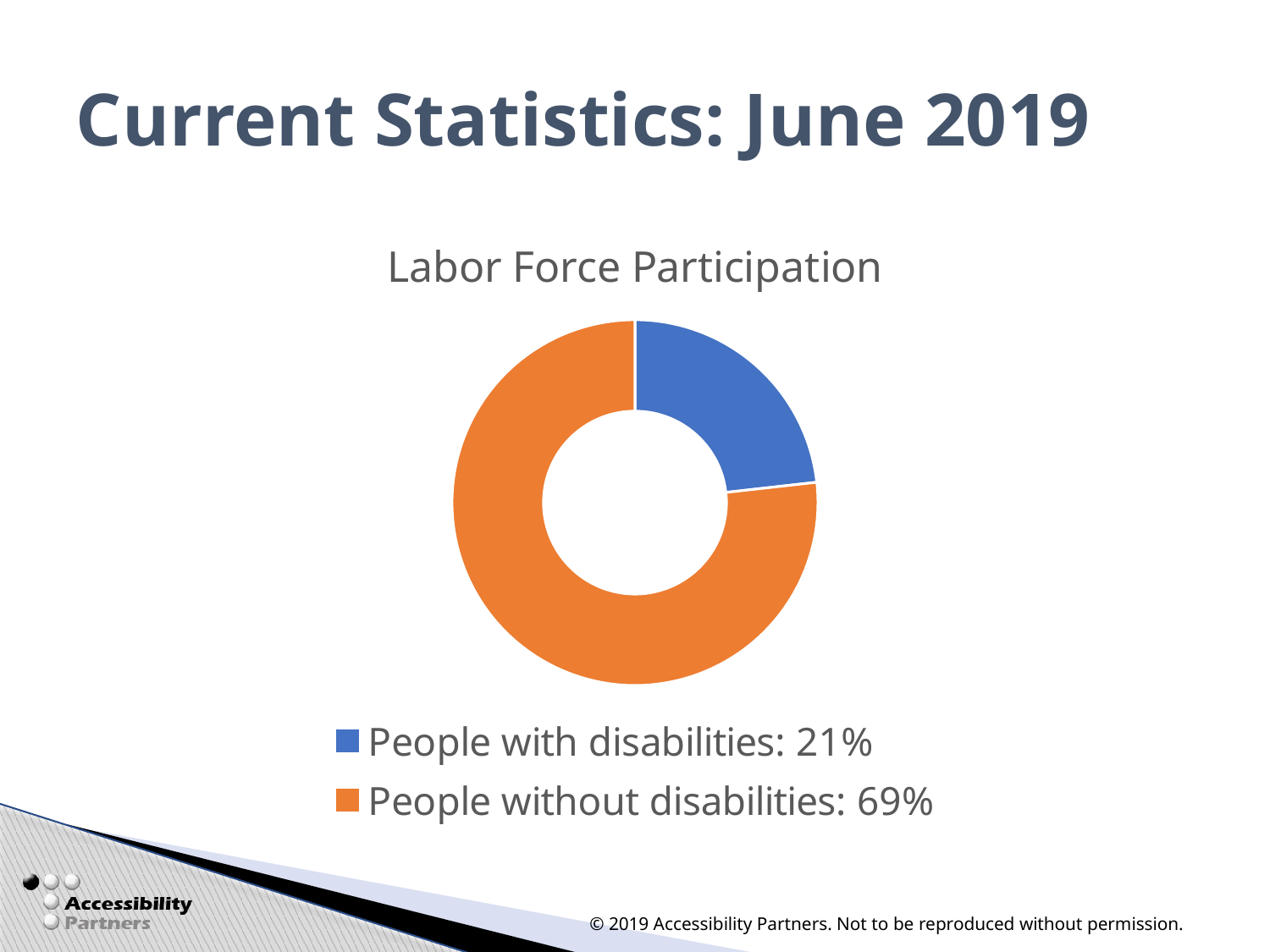
Which colour represents people with disabilities in the chart? Blue What is the title of the chart? Labor Force Participation What kind of chart is shown on the slide? Doughnut (pie) chart What is the labor force participation value for people without disabilities? 69% What is the difference between the labor force participation values for people without disabilities and people with disabilities? 48 percentage points Is the value for people with disabilities larger or smaller than the value for people without disabilities? Smaller Which group has the higher labor force participation value? People without disabilities Which group has the lower labor force participation value? People with disabilities What is the labor force participation value for people with disabilities? 21% How many categories does the chart show? 2